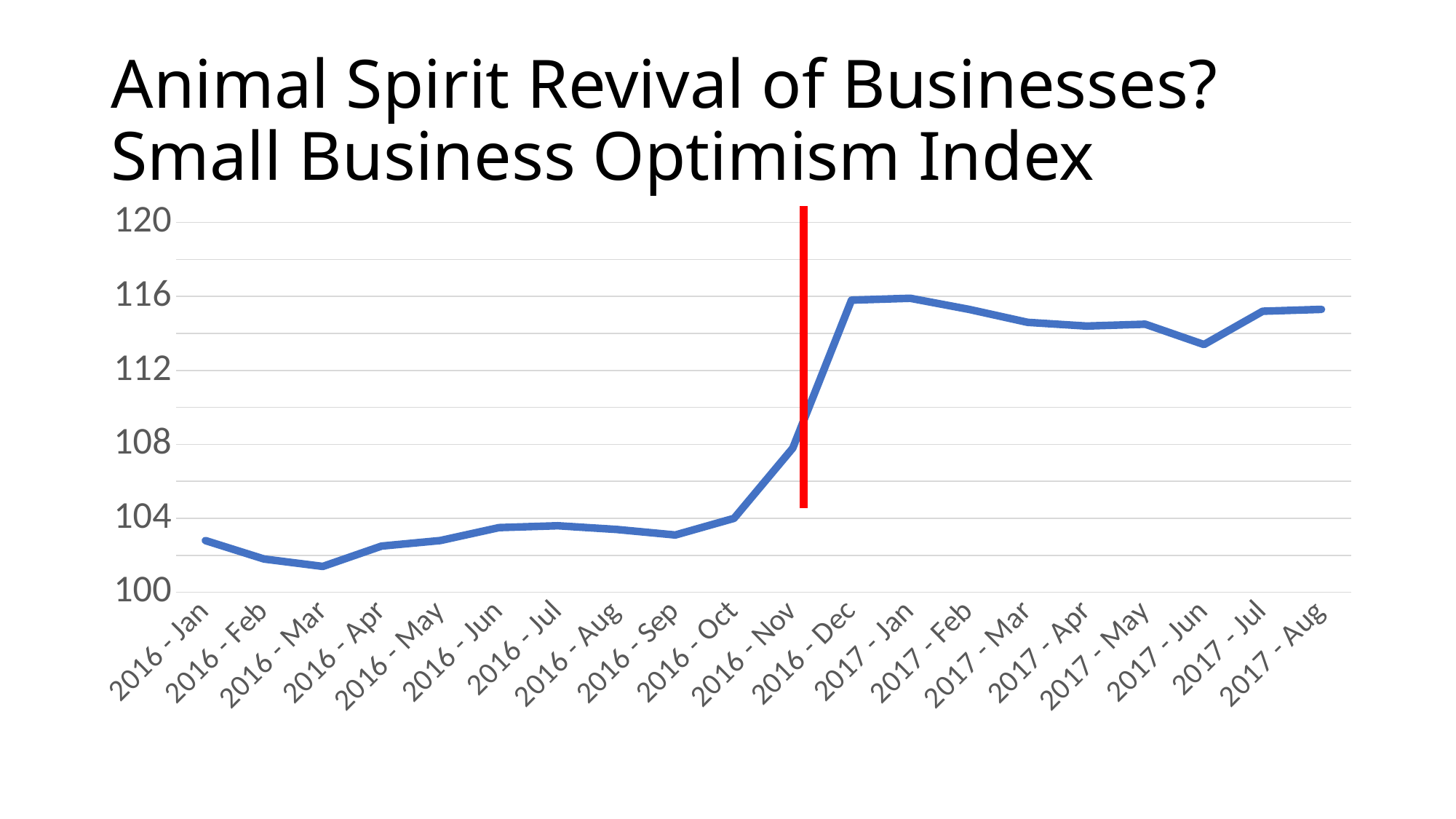
Is the value for 2017 - Jun greater or less than 112? greater Is the value for 2016 - Mar greater or less than 104? less How many monthly data points are plotted on the chart? 20 Which is larger, the value for 2016 - Oct or the value for 2016 - Dec? 2016 - Dec Is the value for 2016 - Dec greater or less than 112? greater Does the index rise or fall between 2016 - Oct and 2016 - Dec? rise Overall, is the index higher or lower at 2017 - Aug than at 2016 - Jan? higher Which is larger, the value for 2017 - Jun or the value for 2017 - Jul? 2017 - Jul Between which two months is the red vertical marker line placed? 2016 - Nov and 2016 - Dec What kind of chart is shown on the slide? line chart